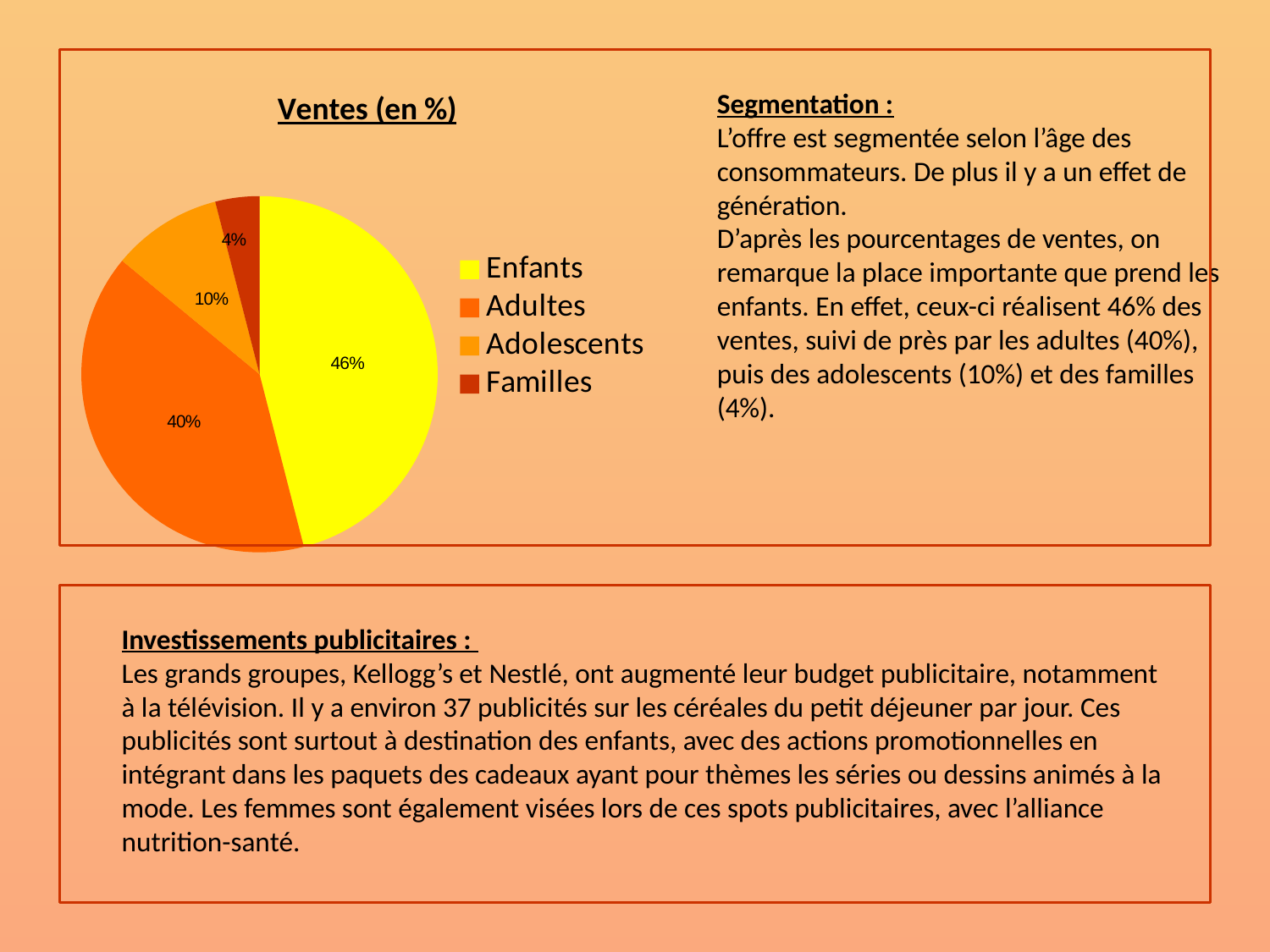
Which is larger, the share for Adolescents or the share for Familles? Adolescents What percentage of sales is attributed to Enfants? 46% What percentage of sales is attributed to Adolescents? 10% Which category has the largest share of sales? Enfants What percentage of sales is attributed to Familles? 4% What is the title of the chart? Ventes (en %) What type of chart is shown on the slide? Pie chart Which category has the smallest share of sales? Familles What percentage of sales is attributed to Adultes? 40% What colour is the Enfants slice in the pie chart? Yellow How many categories does the pie chart show? 4 What is the difference in percentage points between Enfants and Adultes? 6